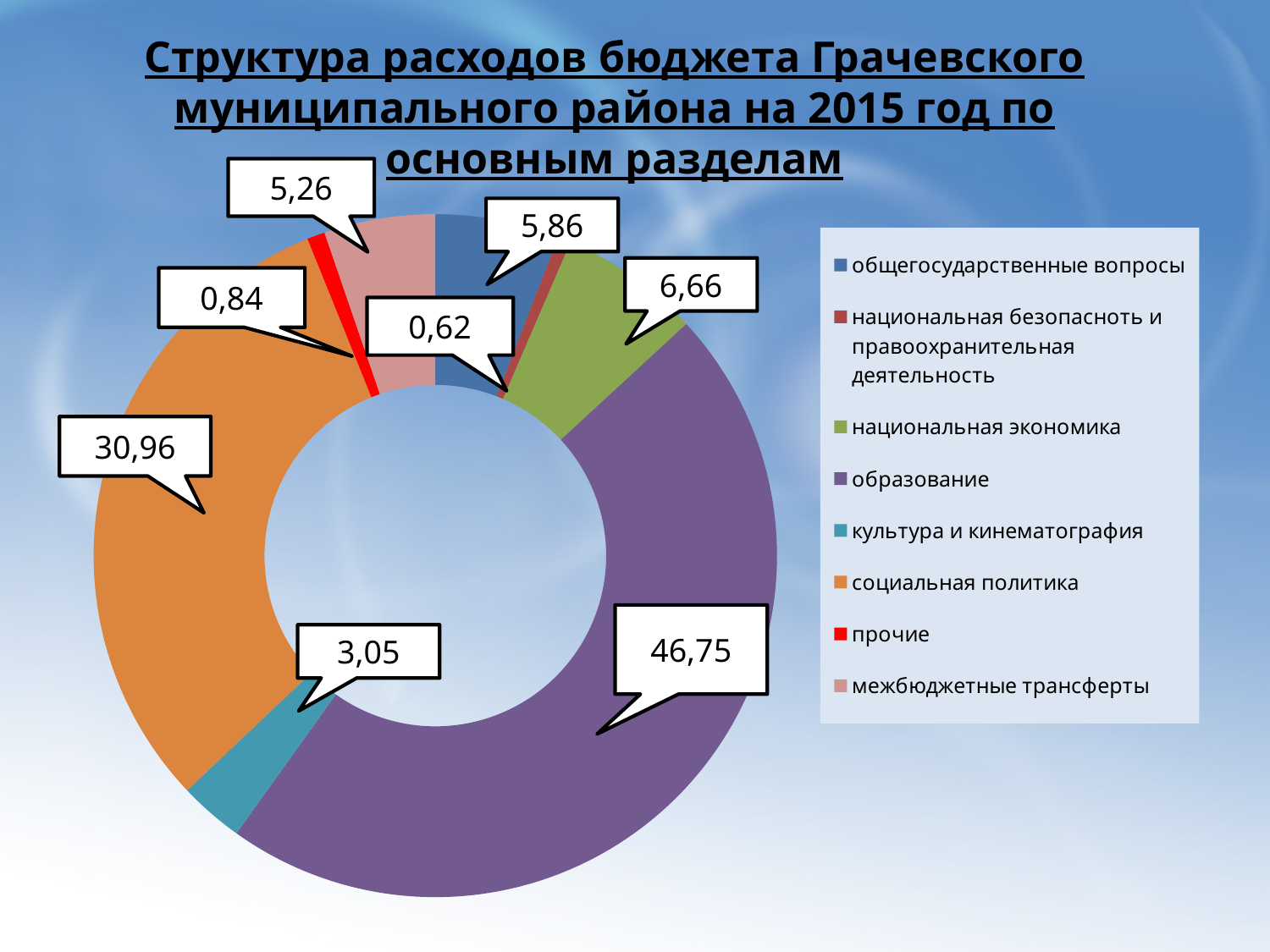
What value is shown for социальная политика? 30,96 What value is shown for национальная экономика? 6,66 Which category has the largest share of the chart? образование What colour is the slice for прочие? red What is the difference between the values for образование and социальная политика? 15,79 How many categories does the chart show? 8 What value is shown for образование? 46,75 What value is shown for культура и кинематография? 3,05 Which category has the smallest share of the chart? национальная безопасноть и правоохранительная деятельность Which is larger, the value for общегосударственные вопросы or the value for национальная экономика? национальная экономика What kind of chart is shown on the slide? doughnut chart What value is shown for межбюджетные трансферты? 5,26